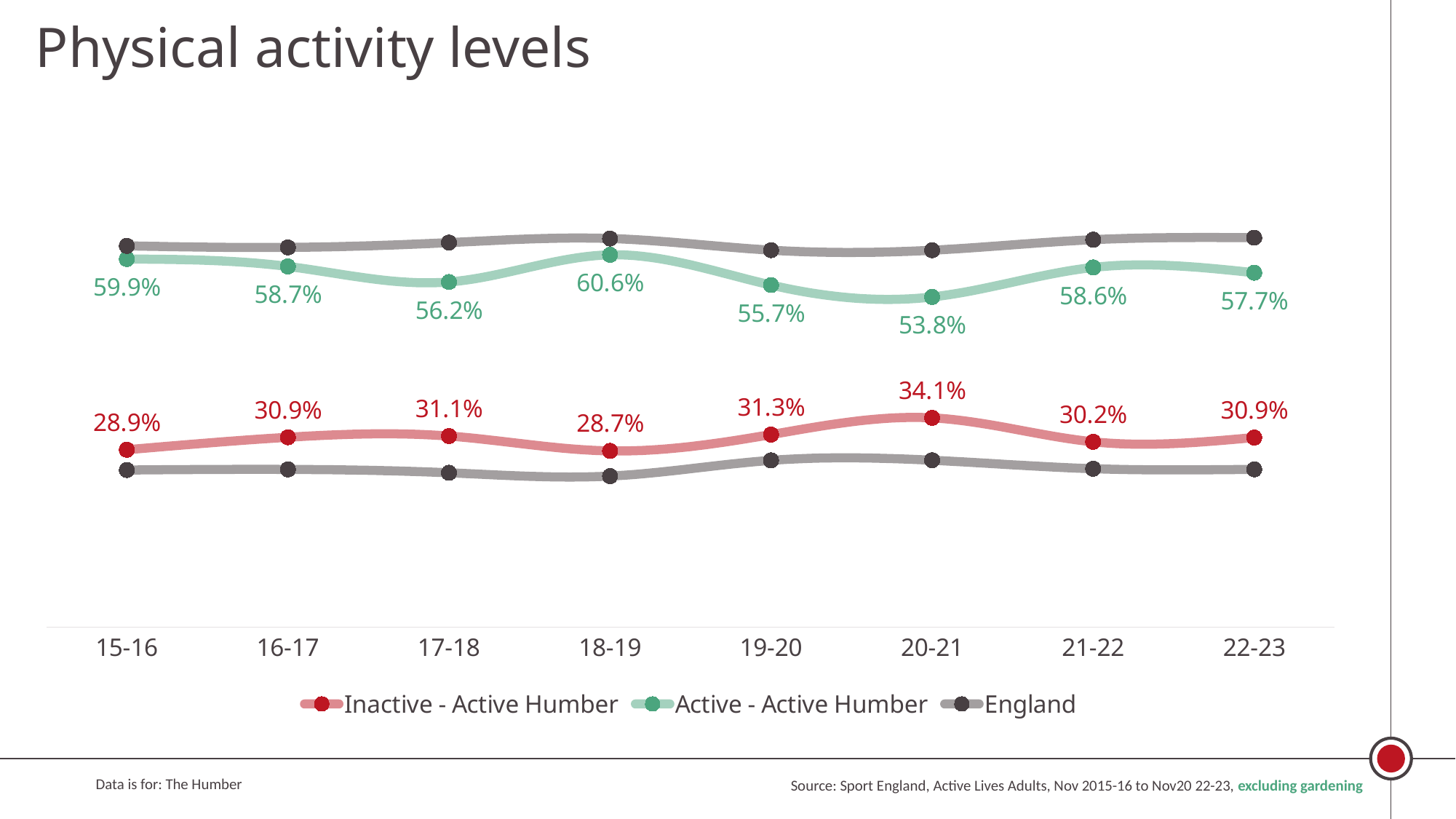
How many series does the legend list? 3 In which period is the Inactive - Active Humber value lowest? 18-19 What is the difference between the Active - Active Humber values for 18-19 and 20-21? 6.8 percentage points What kind of chart is shown on the slide? Line chart What is the Active - Active Humber value for 22-23? 57.7% How many periods are shown on the x axis? 8 Which is larger, the Active - Active Humber value for 15-16 or for 22-23? 15-16 In which period is the Inactive - Active Humber value highest? 20-21 In which period is the Active - Active Humber value lowest? 20-21 What is the Active - Active Humber value for 18-19? 60.6% Does the Active - Active Humber value rise or fall from 18-19 to 20-21? Fall What is the Inactive - Active Humber value for 20-21? 34.1%